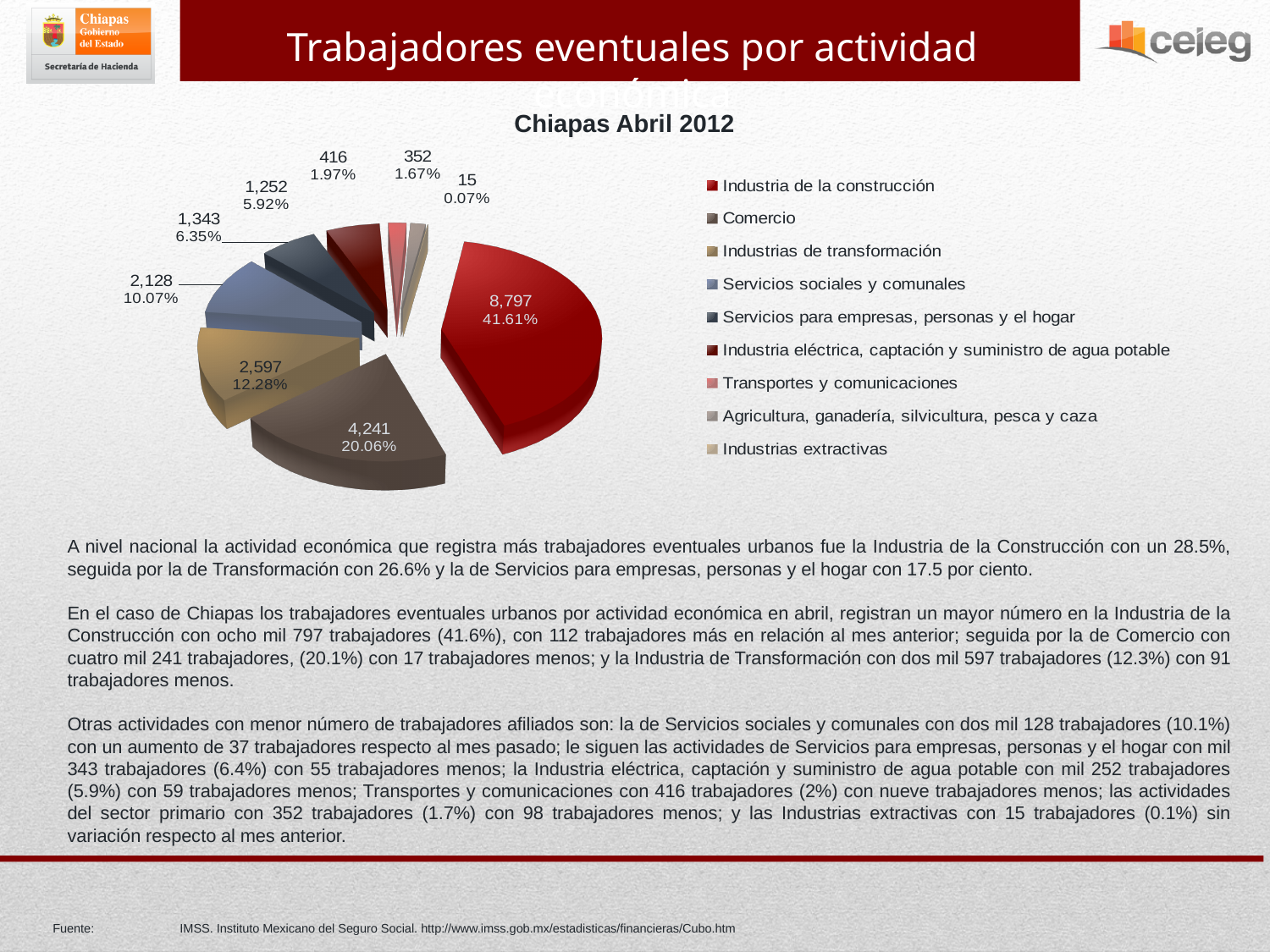
How many categories does the legend of the pie chart list? 9 What subtitle appears directly above the pie chart? Chiapas Abril 2012 What is the difference between the values for Industria de la construcción and Comercio? 4,556 What is the value shown for Industrias de transformación? 2,597 Which is larger, the value for Servicios sociales y comunales or the value for Servicios para empresas, personas y el hogar? Servicios sociales y comunales What kind of chart is shown on the slide? Pie chart What is the value shown for Agricultura, ganadería, silvicultura, pesca y caza? 352 What percentage share is shown for Transportes y comunicaciones? 1.97% What is the value shown for Industria de la construcción? 8,797 Which category has the largest slice of the pie? Industria de la construcción Which category has the smallest slice of the pie? Industrias extractivas What percentage share does the Comercio slice show? 20.06%